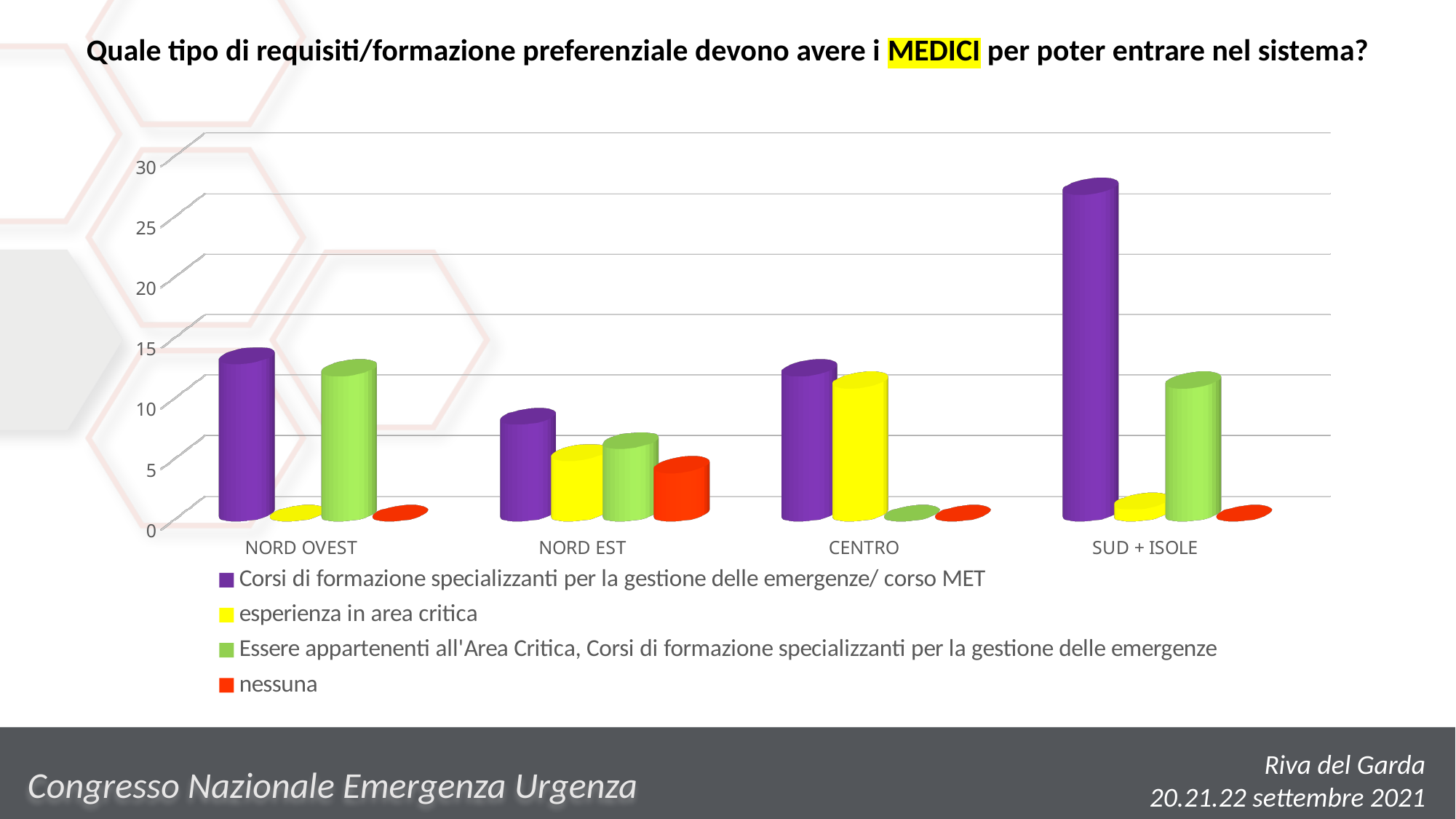
Is the value for 'Corsi di formazione specializzanti per la gestione delle emergenze/ corso MET' in SUD + ISOLE greater or less than 20? greater In NORD OVEST, which is larger: 'Corsi di formazione specializzanti per la gestione delle emergenze/ corso MET' or 'esperienza in area critica'? Corsi di formazione specializzanti per la gestione delle emergenze/ corso MET Which region has the highest value for 'Corsi di formazione specializzanti per la gestione delle emergenze/ corso MET'? SUD + ISOLE In CENTRO, which is larger: 'esperienza in area critica' or 'Essere appartenenti all'Area Critica, Corsi di formazione specializzanti per la gestione delle emergenze'? esperienza in area critica Which colour represents the series 'nessuna' in the legend? red What kind of chart is shown on the slide? bar chart Is the value for 'Essere appartenenti all'Area Critica, Corsi di formazione specializzanti per la gestione delle emergenze' in NORD OVEST greater or less than 10? greater Which word is highlighted in yellow in the slide title? MEDICI How many series does the legend list? 4 Which region has the lowest value for 'Corsi di formazione specializzanti per la gestione delle emergenze/ corso MET'? NORD EST Is the value for 'Corsi di formazione specializzanti per la gestione delle emergenze/ corso MET' in NORD EST greater or less than 15? less How many regions (categories) are shown on the x axis? 4